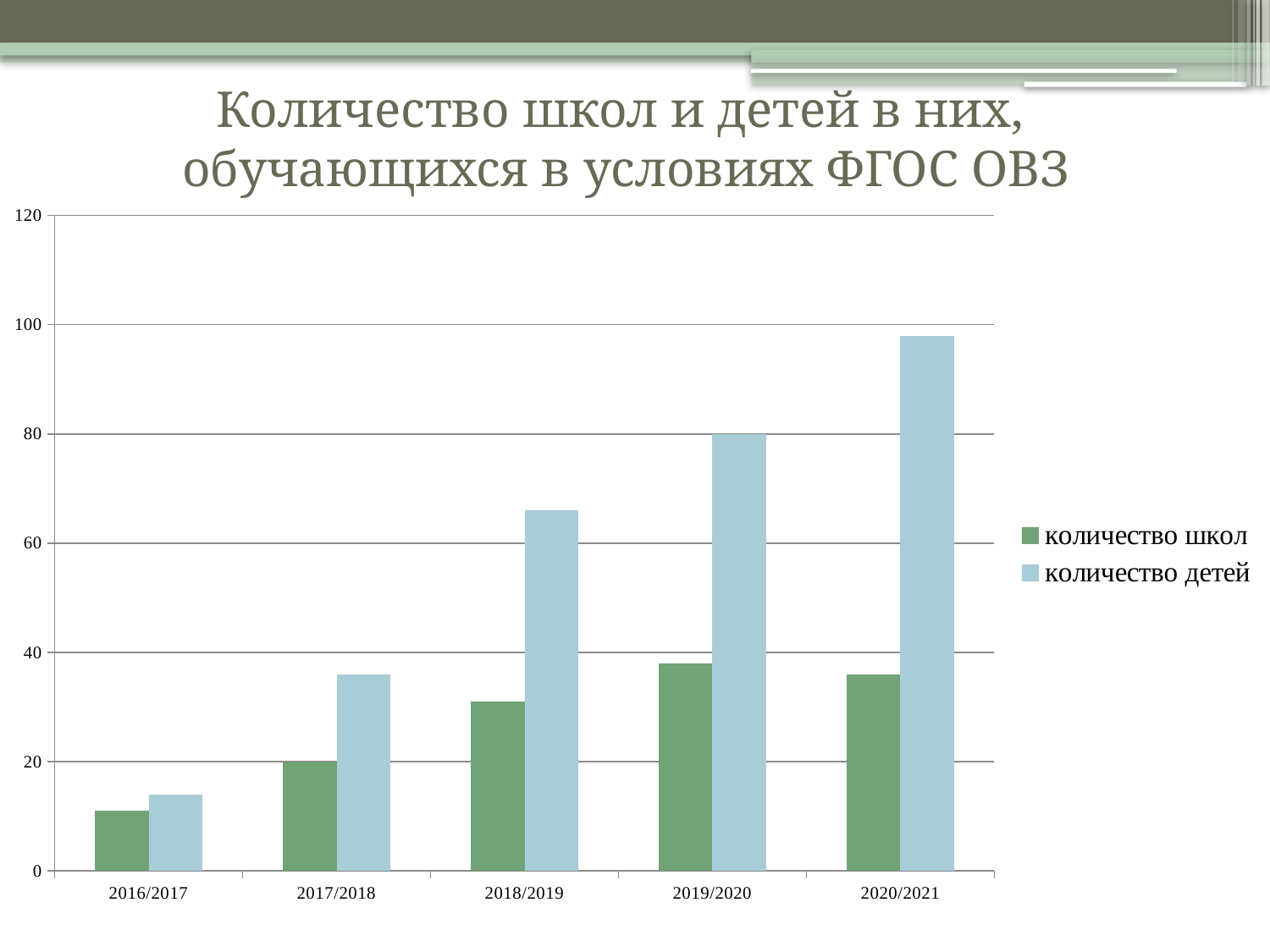
Which school year has the highest value for количество детей? 2020/2021 How many school-year categories are shown on the x axis? 5 Do the values for количество детей rise or fall from 2016/2017 to 2020/2021? rise What kind of chart is shown on the slide? bar chart How many series does the legend list? 2 Which school year has the lowest value for количество школ? 2016/2017 What is the title of the chart? Количество школ и детей в них, обучающихся в условиях ФГОС ОВЗ Which is larger: количество детей in 2018/2019 or количество детей in 2019/2020? 2019/2020 Is the value for количество школ in 2016/2017 greater or less than 20? less Is the value for количество детей in 2018/2019 greater or less than 60? greater Which school year has the lowest value for количество детей? 2016/2017 Is the value for количество детей in 2020/2021 greater or less than 80? greater